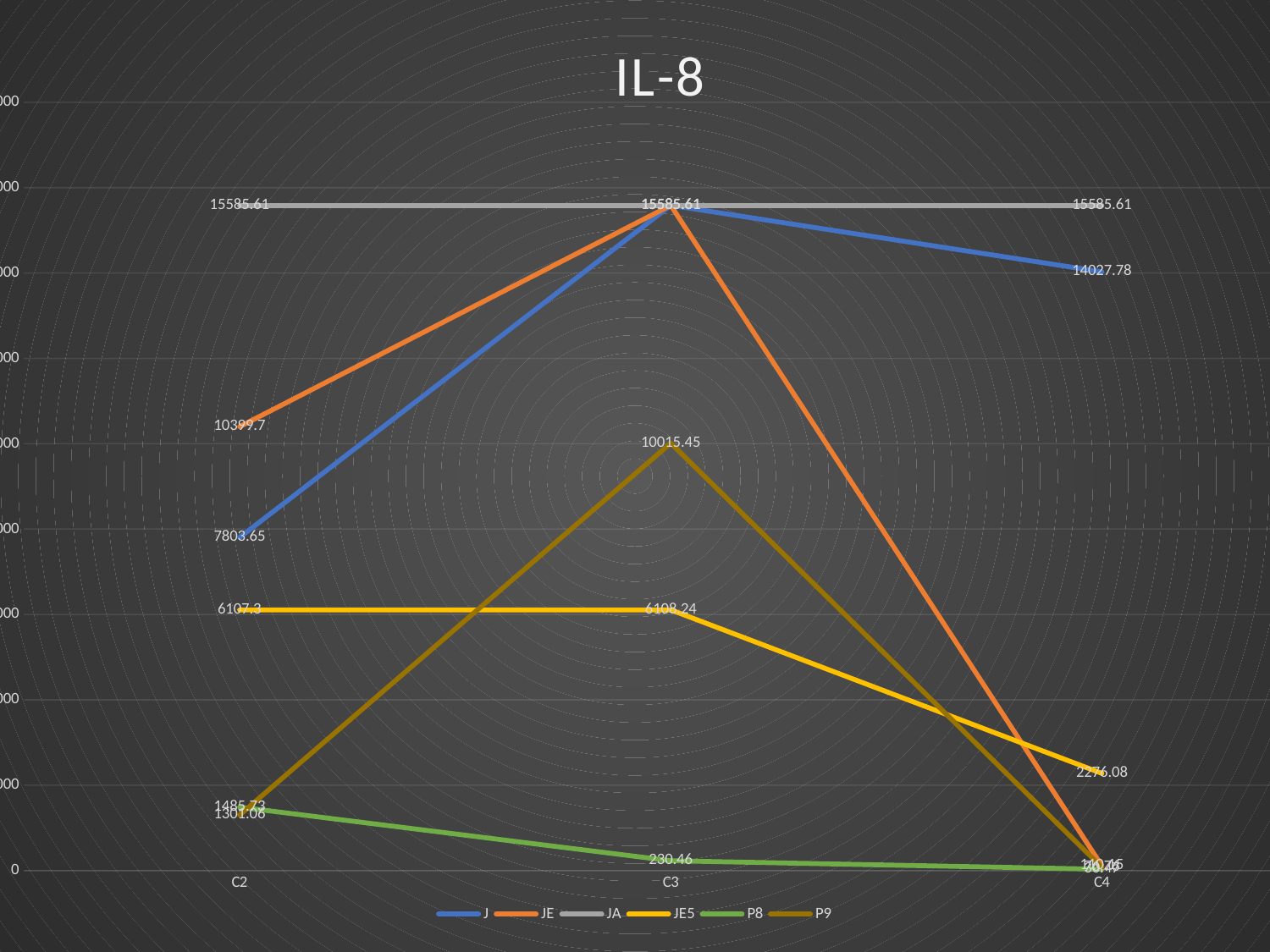
What is the value of series JE at C2? 10399.7 What is the value of series JE5 at C4? 2276.08 What is the value of series J at C4? 14027.78 What is the value of series P9 at C3? 10015.45 What is the value of series J at C2? 7803.65 What type of chart is shown on the slide? line chart How many series does the legend list? 6 How many categories are shown on the x axis? 3 What is the title of the chart? IL-8 What is the value of series P8 at C3? 230.46 Which series has the highest value at C2? JA By how much does series J increase from C2 to C3? 7781.96